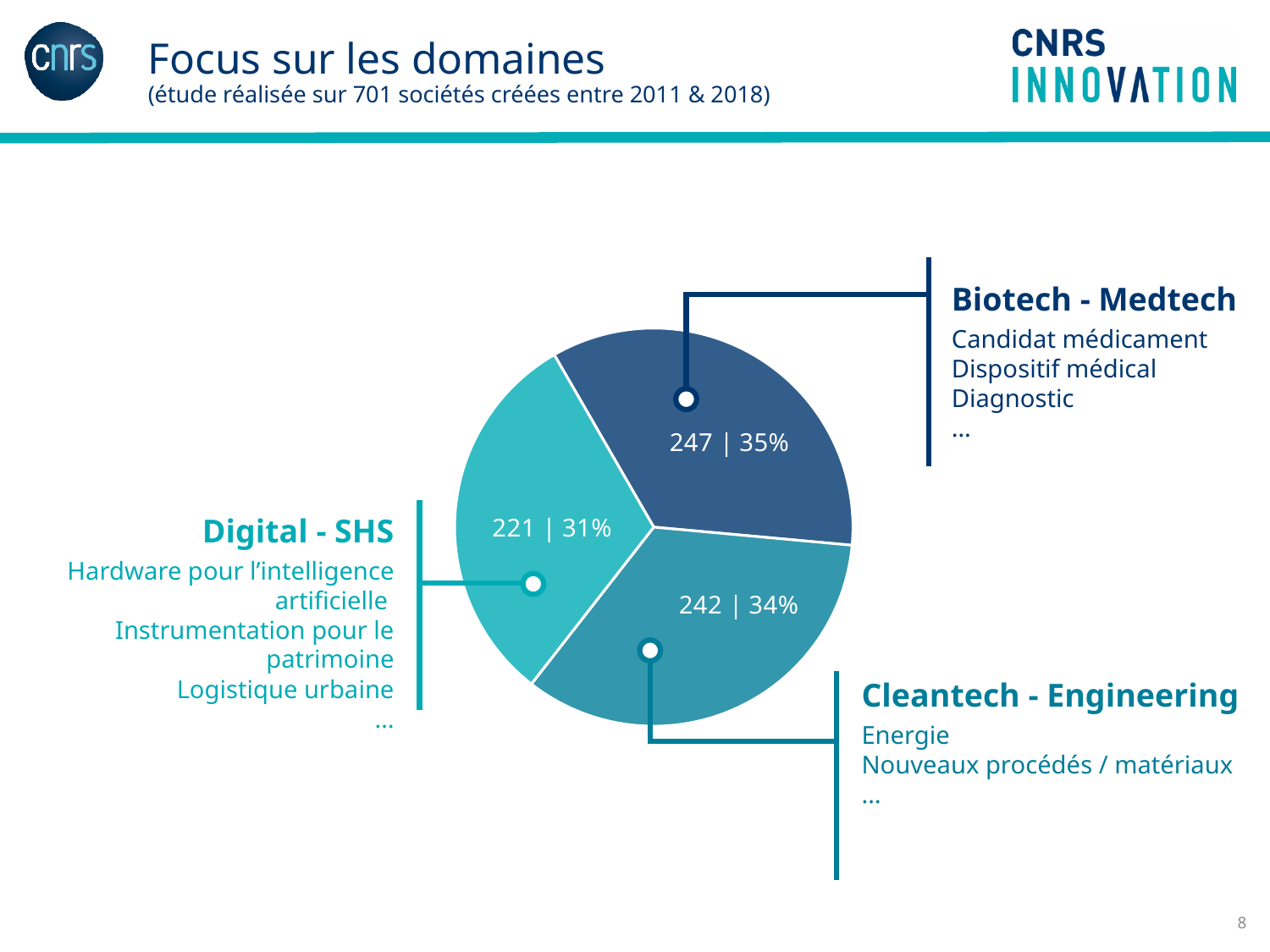
Which domain has the largest slice of the pie? Biotech - Medtech What is the difference in number of companies between Cleantech - Engineering and Digital - SHS? 21 What kind of chart is shown on the slide? pie chart What percentage share does the Digital - SHS slice represent? 31% What is the title of the slide containing the pie chart? Focus sur les domaines What is the difference in number of companies between Biotech - Medtech and Digital - SHS? 26 Which domain has the smallest slice of the pie? Digital - SHS What is the total number of companies across the three slices? 710 How many companies are in the Cleantech - Engineering slice? 242 How many slices does the pie chart have? 3 How many companies are in the Biotech - Medtech slice? 247 What percentage share does the Biotech - Medtech slice represent? 35%